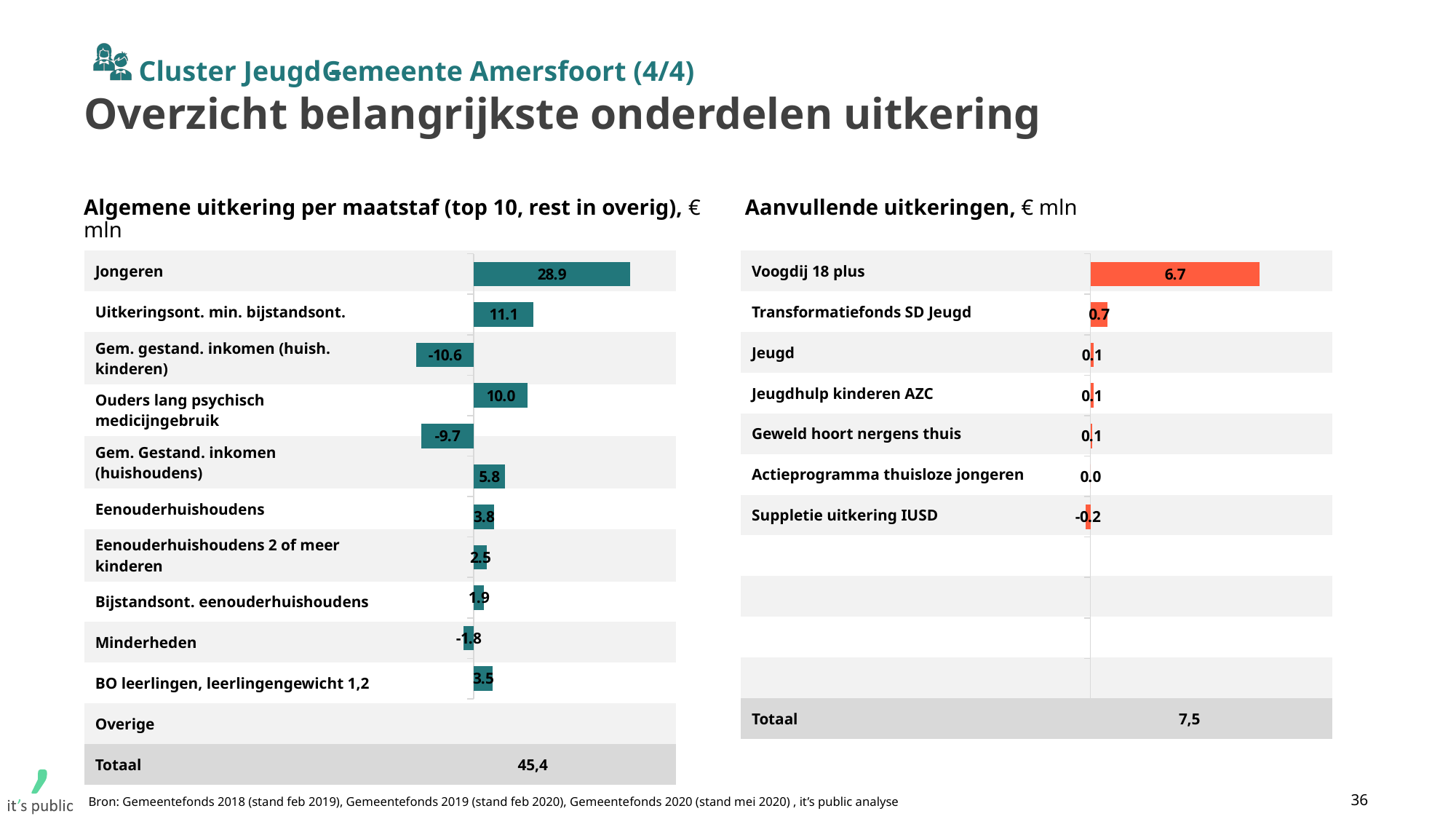
In the chart 'Aanvullende uitkeringen', what is the value for Suppletie uitkering IUSD? -0.2 In the chart 'Algemene uitkering per maatstaf', what is the difference between Jongeren and Uitkeringsont. min. bijstandsont.? 17.8 In the chart 'Aanvullende uitkeringen', which category has the lowest value? Suppletie uitkering IUSD In the chart 'Algemene uitkering per maatstaf', what is the Totaal shown? 45,4 In the chart 'Aanvullende uitkeringen', what is the value for Voogdij 18 plus? 6.7 In the chart 'Aanvullende uitkeringen', what is the difference between Voogdij 18 plus and Transformatiefonds SD Jeugd? 6.0 In the chart 'Aanvullende uitkeringen', how many categories are plotted? 7 In the chart 'Algemene uitkering per maatstaf', what is the value for Jongeren? 28.9 In the chart 'Algemene uitkering per maatstaf', which category has the highest value? Jongeren In the chart 'Algemene uitkering per maatstaf', what is the value for Uitkeringsont. min. bijstandsont.? 11.1 What kind of chart is 'Aanvullende uitkeringen'? Bar chart In the chart 'Algemene uitkering per maatstaf', what is the value for Gem. gestand. inkomen (huish. kinderen)? -10.6